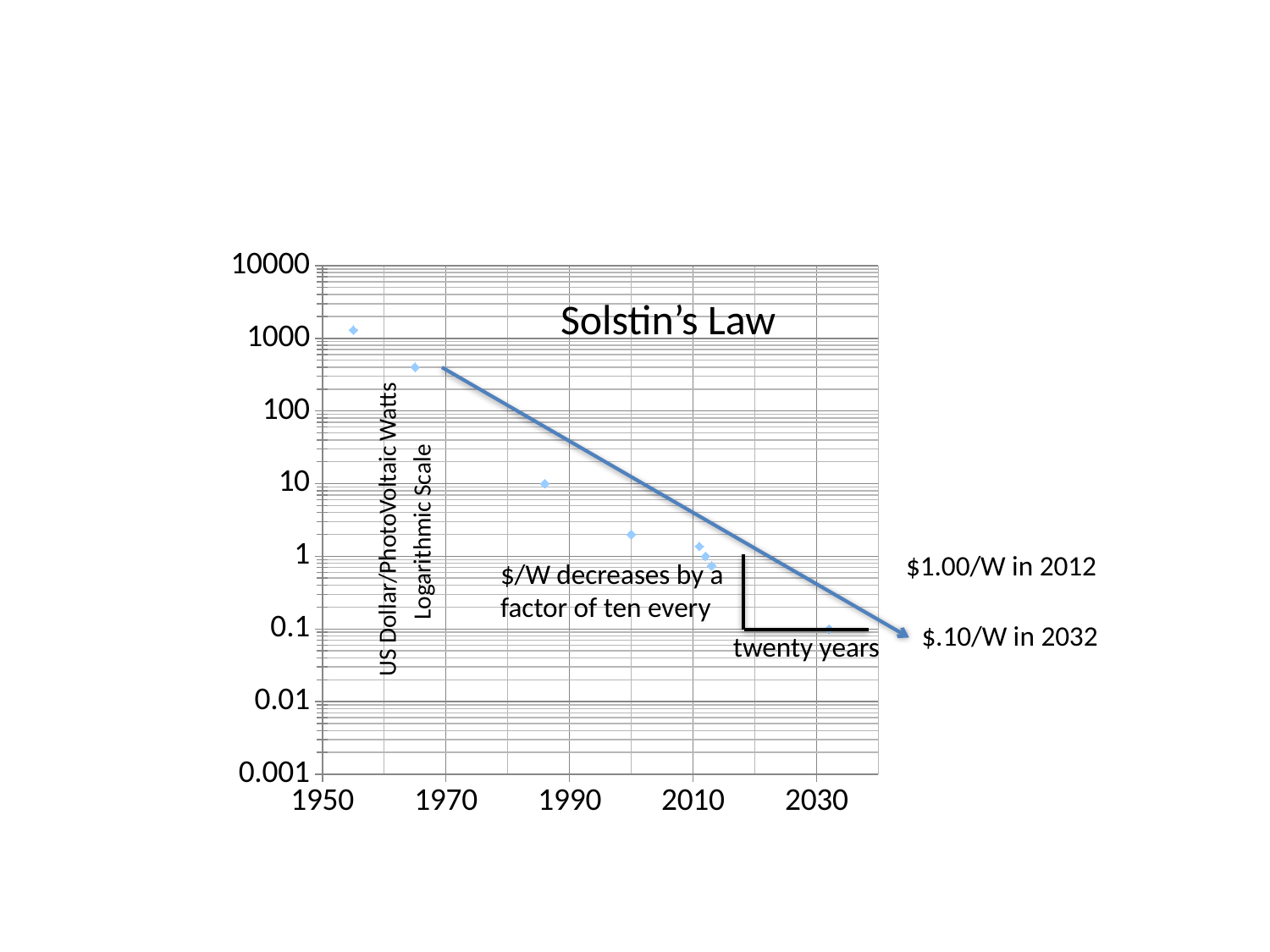
According to the annotation on the chart, what is the $/W value in 2032? $.10/W What is the highest value shown on the vertical axis? 10000 By what factor does the chart say $/W decreases every twenty years? ten Which is larger, the value plotted around 1965 or the value plotted around 1986? 1965 Is the value of the point plotted around 1965 greater or less than 100? greater Do the plotted values rise or fall as the years increase along the x axis? fall What kind of chart is shown on the slide? scatter chart Is the value of the point plotted around 2000 greater or less than 10? less What is the title of the chart? Solstin's Law What is the label on the vertical axis of the chart? US Dollar/PhotoVoltaic Watts Logarithmic Scale According to the annotation on the chart, what is the $/W value in 2012? $1.00/W Is the value of the earliest plotted point (around 1955) greater or less than 1000? greater